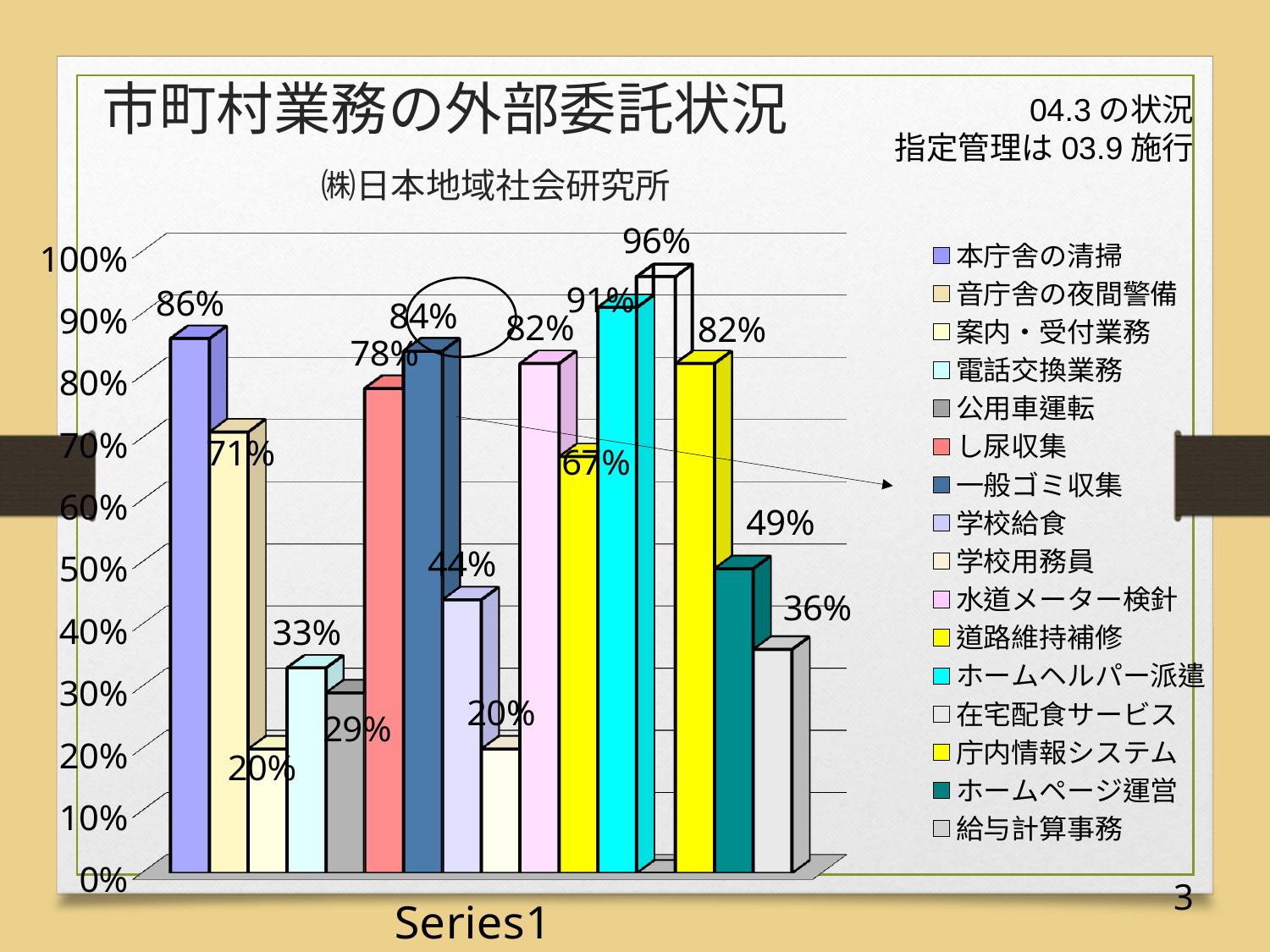
What is the value for 公用車運転? 29% What type of chart is shown on the slide? bar chart What is the difference between the values for 在宅配食サービス and ホームヘルパー派遣? 5% What is the title of the chart on the slide? 市町村業務の外部委託状況 What is the value for 本庁舎の清掃? 86% What is the difference between the values for 一般ゴミ収集 and し尿収集? 6% Which is larger, the value for 本庁舎の清掃 or the value for 音庁舎の夜間警備? 本庁舎の清掃 What is the value for 在宅配食サービス? 96% Is the value for 学校給食 greater or less than 50%? less What is the value for ホームヘルパー派遣? 91% Which legend entry has the highest value in the chart? 在宅配食サービス How many entries does the chart legend list? 16